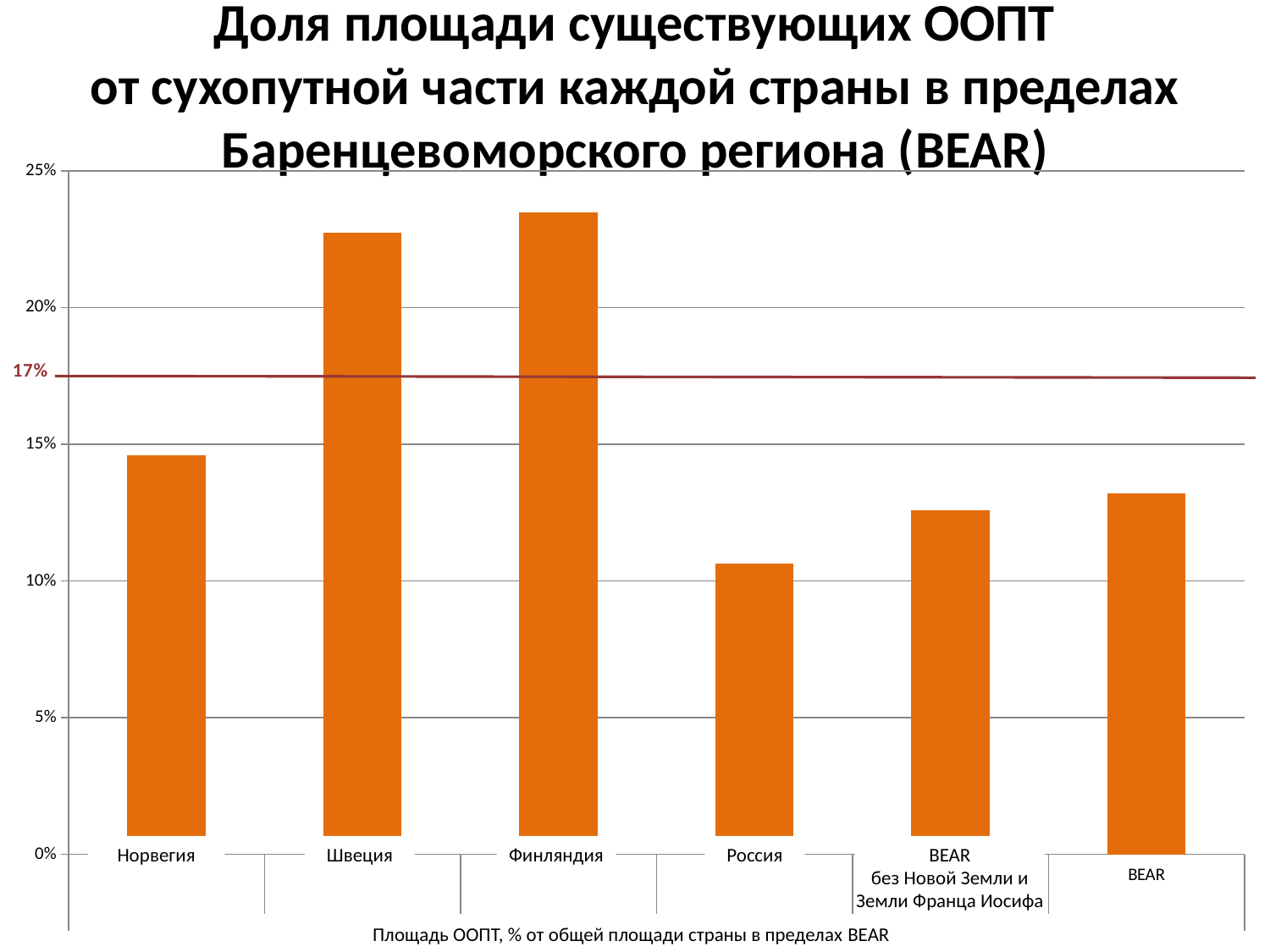
Is the value for Россия greater or less than 10%? greater How many categories are plotted on the chart? 6 Is the value for BEAR greater or less than 15%? less Is the value for Норвегия greater or less than 15%? less Which is larger, the value for BEAR or the value for BEAR без Новой Земли и Земли Франца Иосифа? BEAR What value is marked by the horizontal red reference line on the chart? 17% Which category has the highest value? Финляндия Which category has the lowest value? Россия What kind of chart is shown on the slide? bar chart Which is larger, the value for Норвегия or the value for Россия? Норвегия